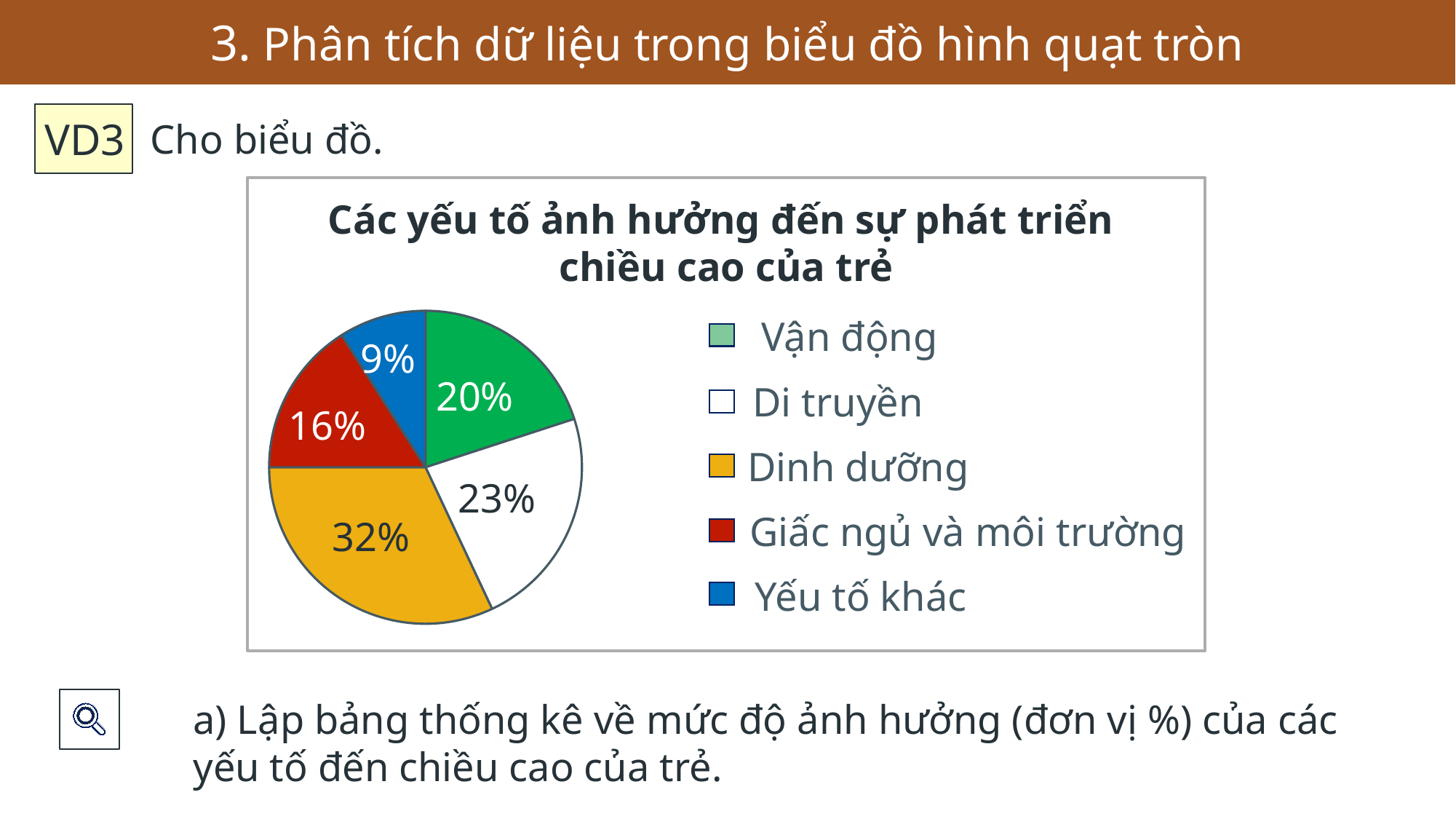
What percentage does the Di truyền slice represent? 23% Which factor has the largest share of the pie? Dinh dưỡng What percentage does the Yếu tố khác slice represent? 9% What percentage does the Dinh dưỡng slice represent? 32% What percentage does the Vận động slice represent? 20% What is the title of the pie chart? Các yếu tố ảnh hưởng đến sự phát triển chiều cao của trẻ What kind of chart is shown on the slide? pie chart Which is larger, the share for Di truyền or the share for Giấc ngủ và môi trường? Di truyền Which factor has the smallest share of the pie? Yếu tố khác What percentage does the Giấc ngủ và môi trường slice represent? 16% What is the difference between the Dinh dưỡng share and the Vận động share? 12% How many slices does the pie chart have? 5